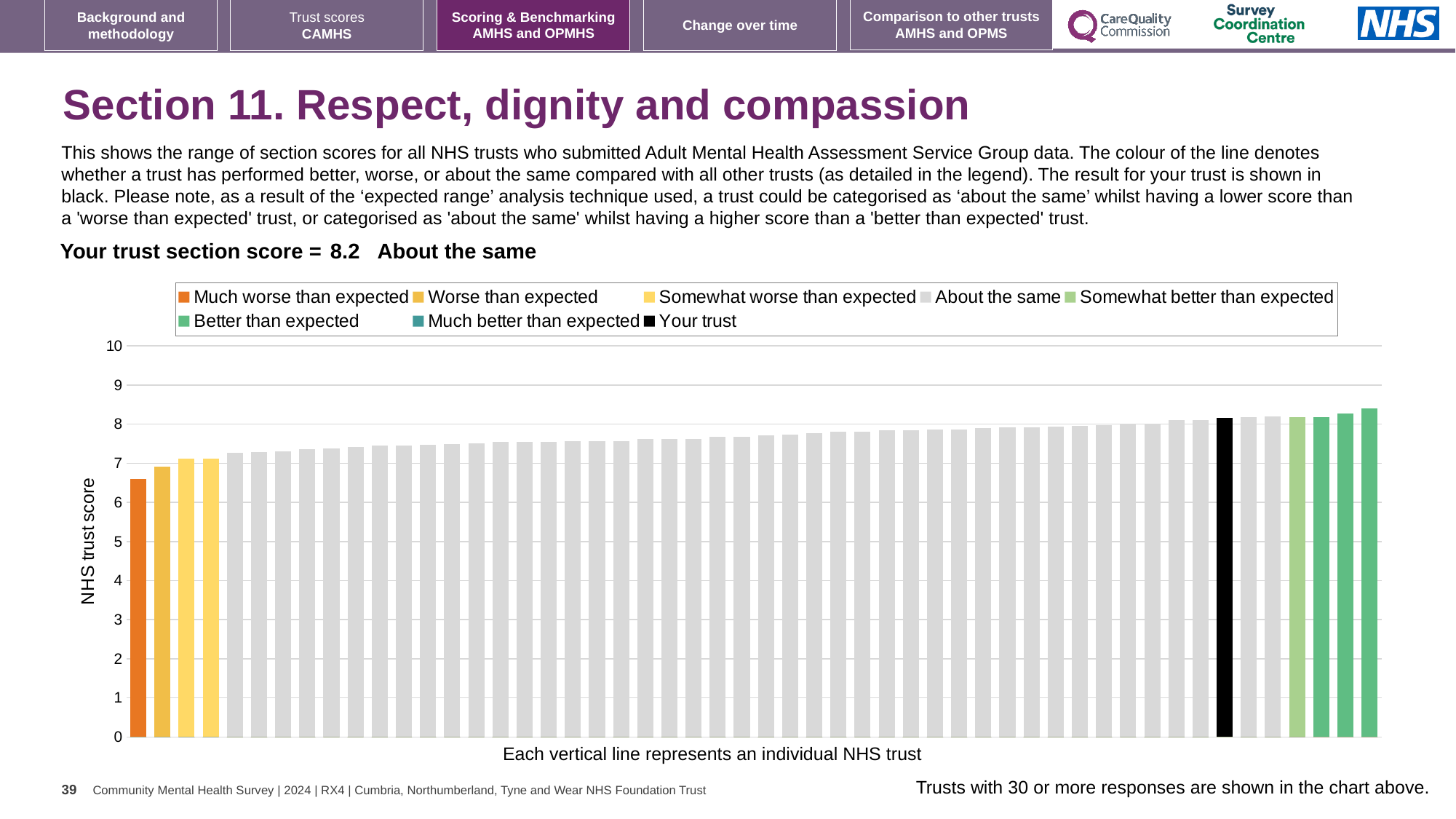
What is your trust's section score shown on the slide? 8.2 What kind of chart is shown on the slide? Bar chart Do the bar values rise or fall from left to right across the chart? Rise Is the value of the lowest (orange) bar greater or less than 7? less How many entries does the chart legend list? 8 What is the label on the vertical axis of the chart? NHS trust score What colour is used for the 'Your trust' bar in the chart? Black How is your trust categorised compared with other trusts, according to the text above the chart? About the same Which is larger: the black 'Your trust' bar or the orange 'Much worse than expected' bar? The black 'Your trust' bar How many bars in the chart are coloured orange (Much worse than expected)? 1 Is the value of the tallest bar in the chart greater or less than 9? less Is the value of the black 'Your trust' bar greater or less than 8? greater